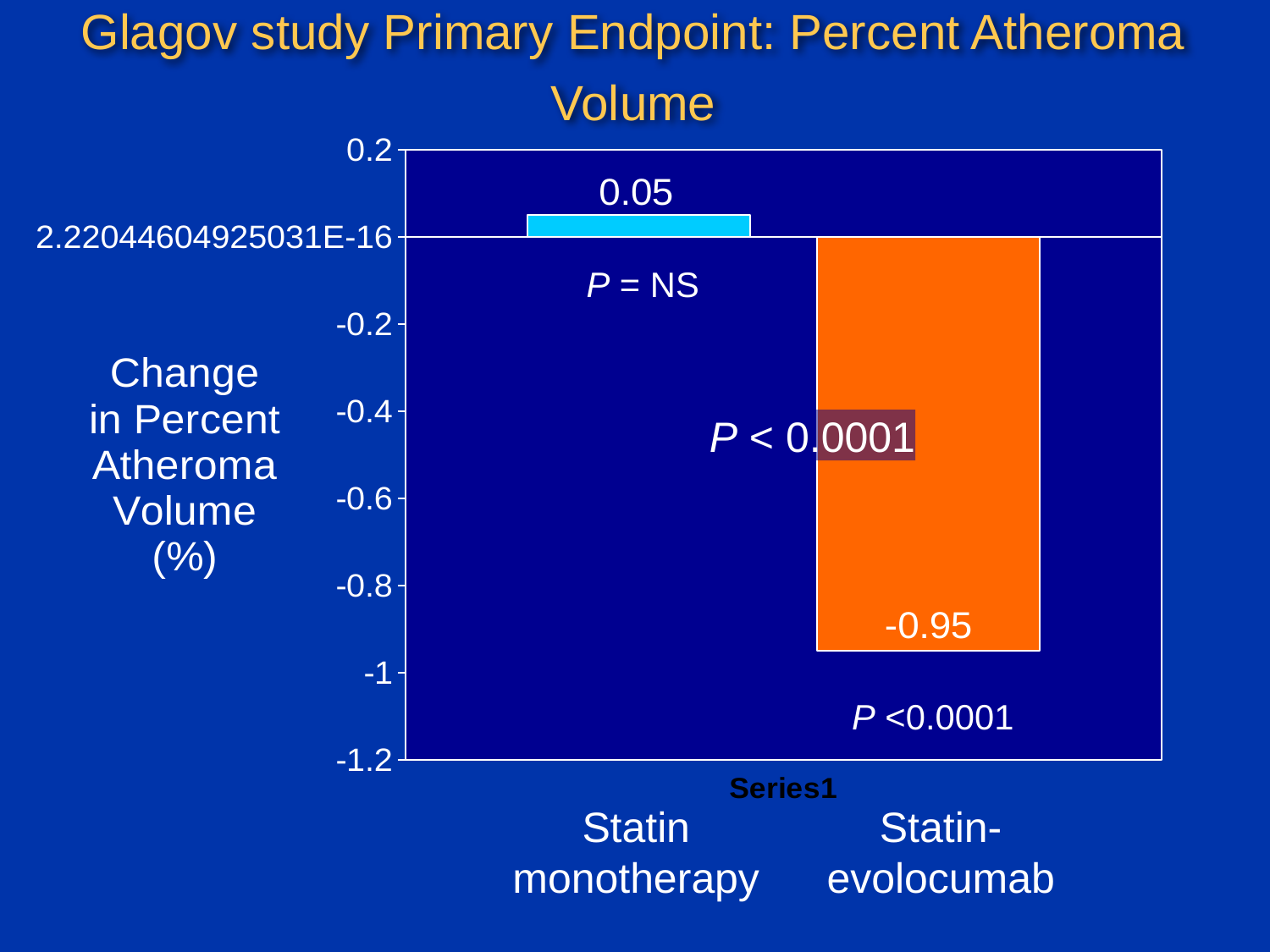
What is the y-axis label of the chart? Change in Percent Atheroma Volume (%) Which treatment group has the highest change in percent atheroma volume? Statin monotherapy Which is larger, the value for Statin monotherapy or the value for Statin-evolocumab? Statin monotherapy What P value is shown for the Statin monotherapy bar? P = NS What is the change in percent atheroma volume for Statin monotherapy? 0.05 How many treatment groups are shown in the chart? 2 Which treatment group has the lowest change in percent atheroma volume? Statin-evolocumab What is the title of the slide? Glagov study Primary Endpoint: Percent Atheroma Volume What kind of chart is shown on the slide? bar chart Is the value for Statin-evolocumab greater or less than -0.8? less What is the difference between the values for Statin monotherapy and Statin-evolocumab? 1 What is the change in percent atheroma volume for Statin-evolocumab? -0.95